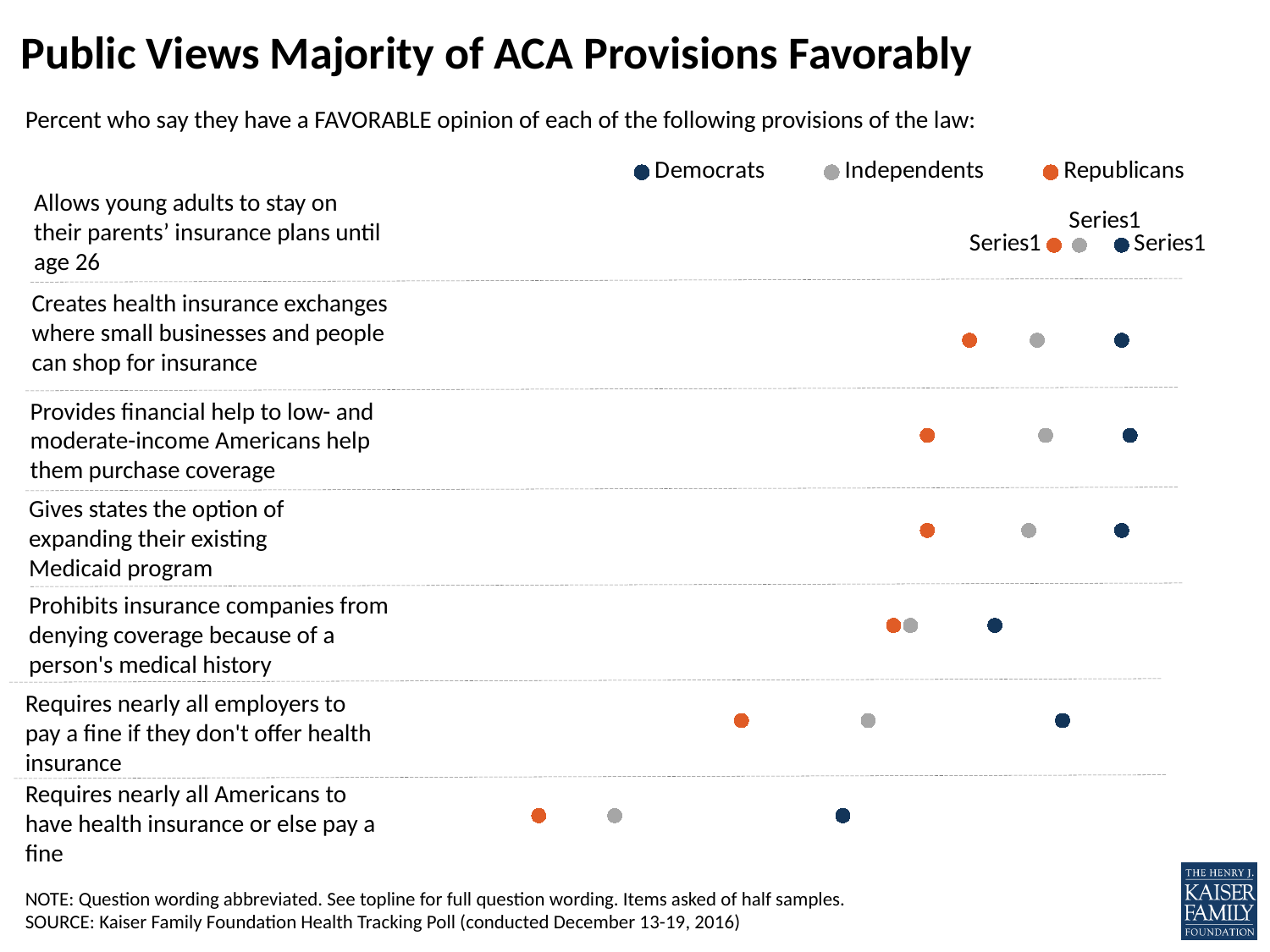
For the provision requiring nearly all Americans to have health insurance or else pay a fine, which group has the highest favorable share? Democrats How many ACA provisions are plotted on the chart? 7 For the provision requiring nearly all employers to pay a fine if they don't offer health insurance, is the favorable share larger for Democrats or Republicans? Democrats Which provision has the lowest favorable share among Democrats? Requires nearly all Americans to have health insurance or else pay a fine What kind of chart is shown on the slide? Dot plot For the provision creating health insurance exchanges, is the favorable share larger for Independents or Republicans? Independents How many series does the legend list? 3 Which provision has the lowest favorable share among Republicans? Requires nearly all Americans to have health insurance or else pay a fine For the provision requiring nearly all Americans to have health insurance or else pay a fine, which group has the lowest favorable share? Republicans Which group is listed first in the legend? Democrats What colour are the Republicans markers? Orange